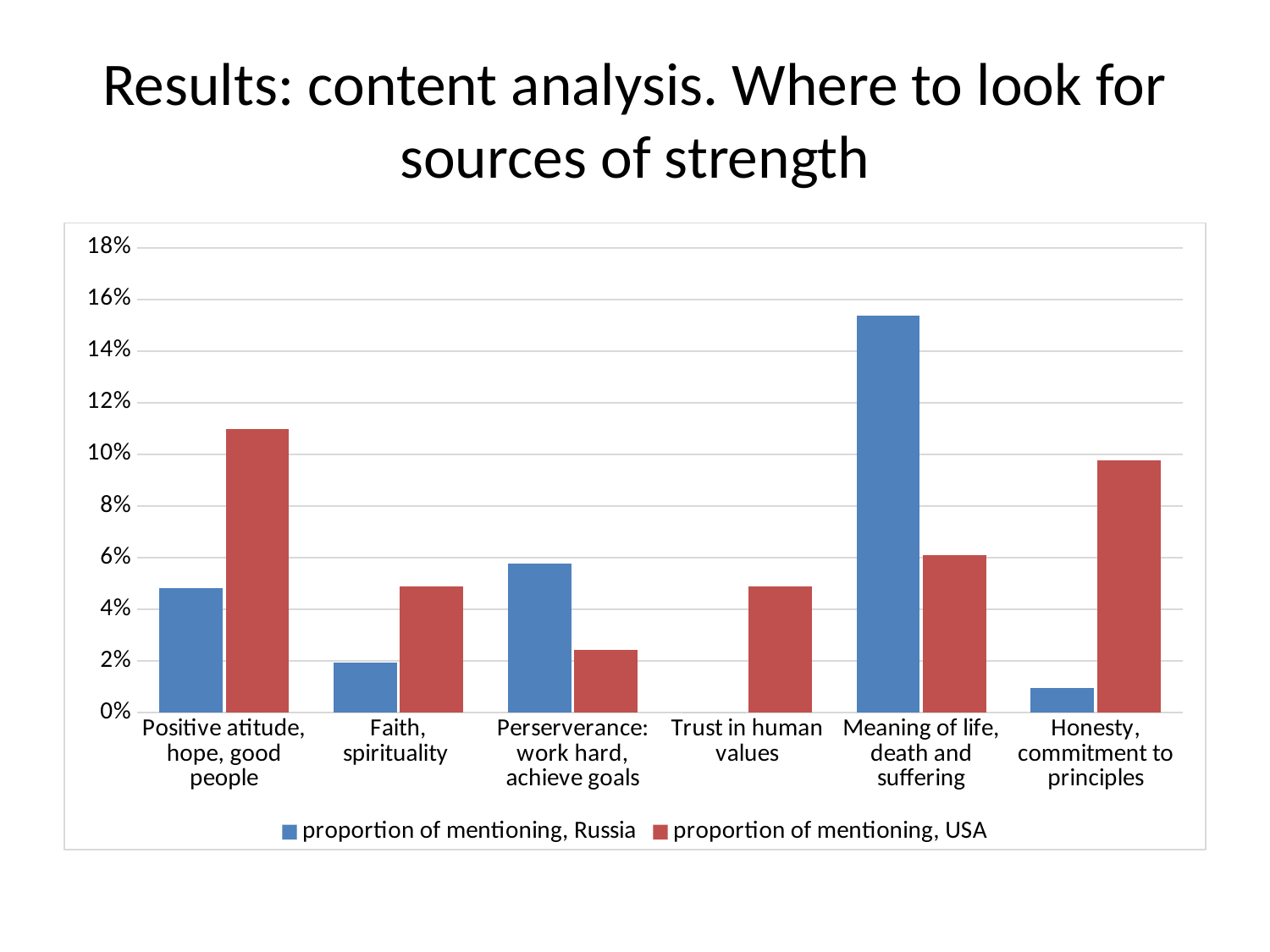
How many series does the legend list? 2 Which category has the highest value for proportion of mentioning, USA? Positive atitude, hope, good people How many categories are shown on the x axis? 6 Which category has the lowest value for proportion of mentioning, USA? Perserverance: work hard, achieve goals Which category has the highest value for proportion of mentioning, Russia? Meaning of life, death and suffering For Perserverance: work hard, achieve goals, which series has the larger value: proportion of mentioning, Russia or proportion of mentioning, USA? proportion of mentioning, Russia Is the value for proportion of mentioning, USA for Perserverance: work hard, achieve goals greater or less than 4%? less Is the value for proportion of mentioning, USA for Positive atitude, hope, good people greater or less than 10%? greater For Positive atitude, hope, good people, which series has the larger value: proportion of mentioning, Russia or proportion of mentioning, USA? proportion of mentioning, USA Is the value for proportion of mentioning, Russia for Meaning of life, death and suffering greater or less than 14%? greater Which colour represents proportion of mentioning, USA in the legend? red What kind of chart is shown on the slide? bar chart